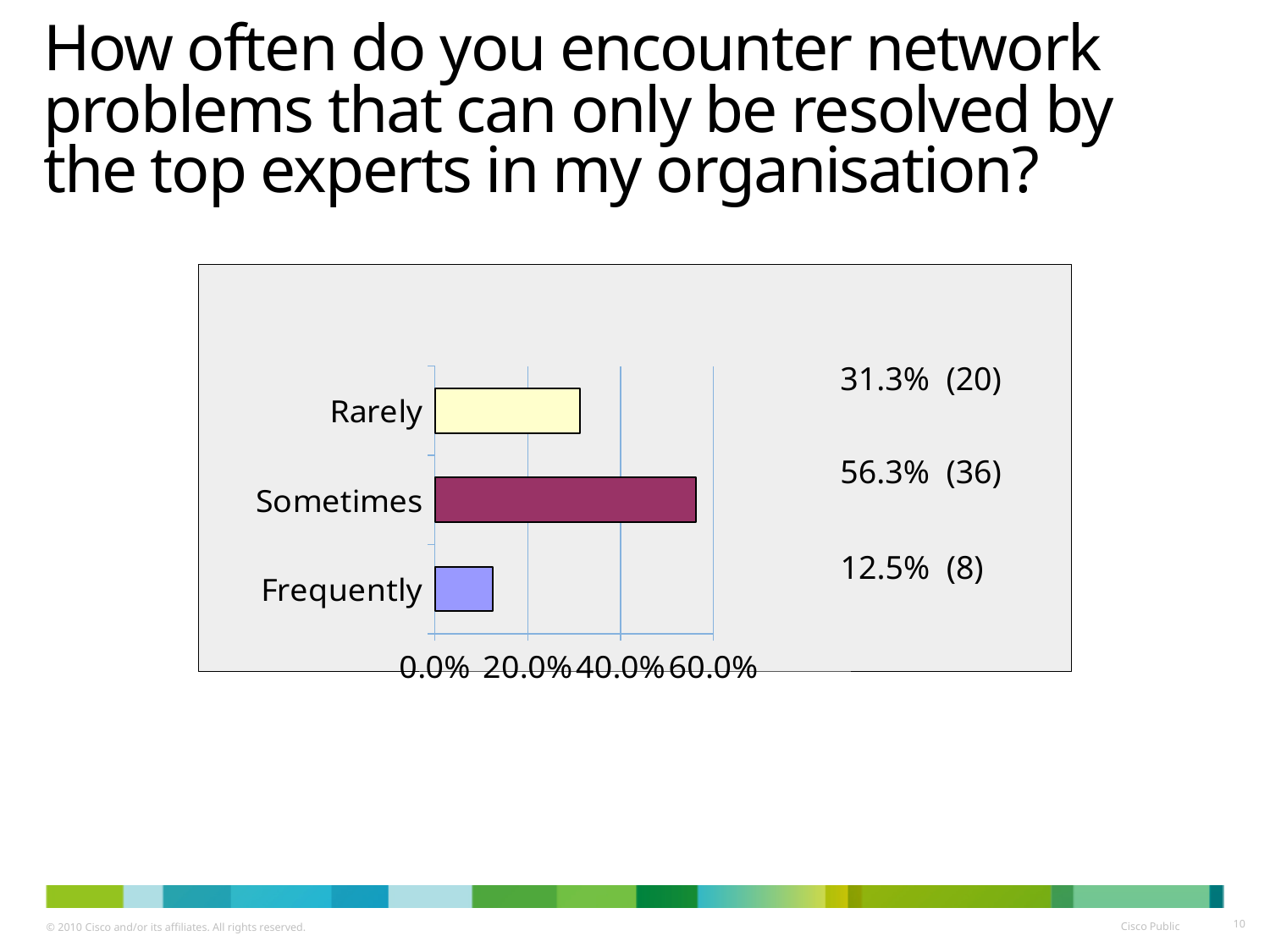
Which response category has the lowest percentage? Frequently What colour is the bar for "Sometimes"? dark magenta What kind of chart is shown on the slide? bar chart What percentage of respondents answered "Rarely"? 31.3% What percentage of respondents answered "Sometimes"? 56.3% Is the value for "Sometimes" greater or less than 40.0%? greater Which is larger, the percentage for "Rarely" or for "Frequently"? Rarely How many respondents answered "Frequently"? 8 How many response categories are shown in the chart? 3 What is the total number of respondents across all three categories? 64 Which response category has the highest percentage? Sometimes What is the difference in percentage points between "Sometimes" and "Rarely"? 25.0%